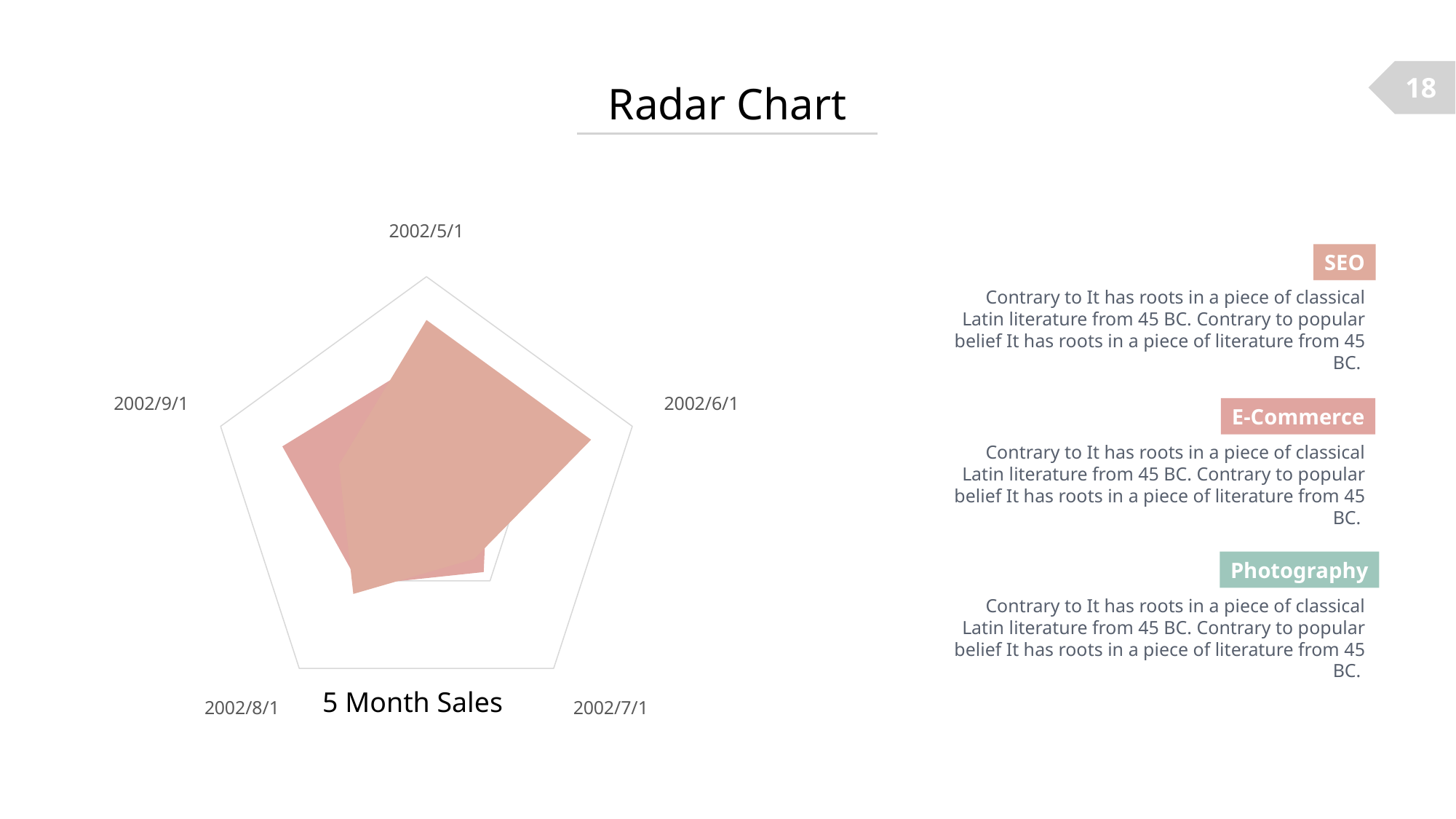
Which category label is on the left side of the radar chart? 2002/9/1 Which category label is on the right side of the radar chart? 2002/6/1 Which category label appears at the top of the radar chart? 2002/5/1 How many categories (axes) does the radar chart have? 5 Which category label is at the bottom left of the radar chart? 2002/8/1 What is the title of the radar chart? 5 Month Sales What kind of chart is shown on the slide? Radar chart Which category label is at the bottom right of the radar chart? 2002/7/1